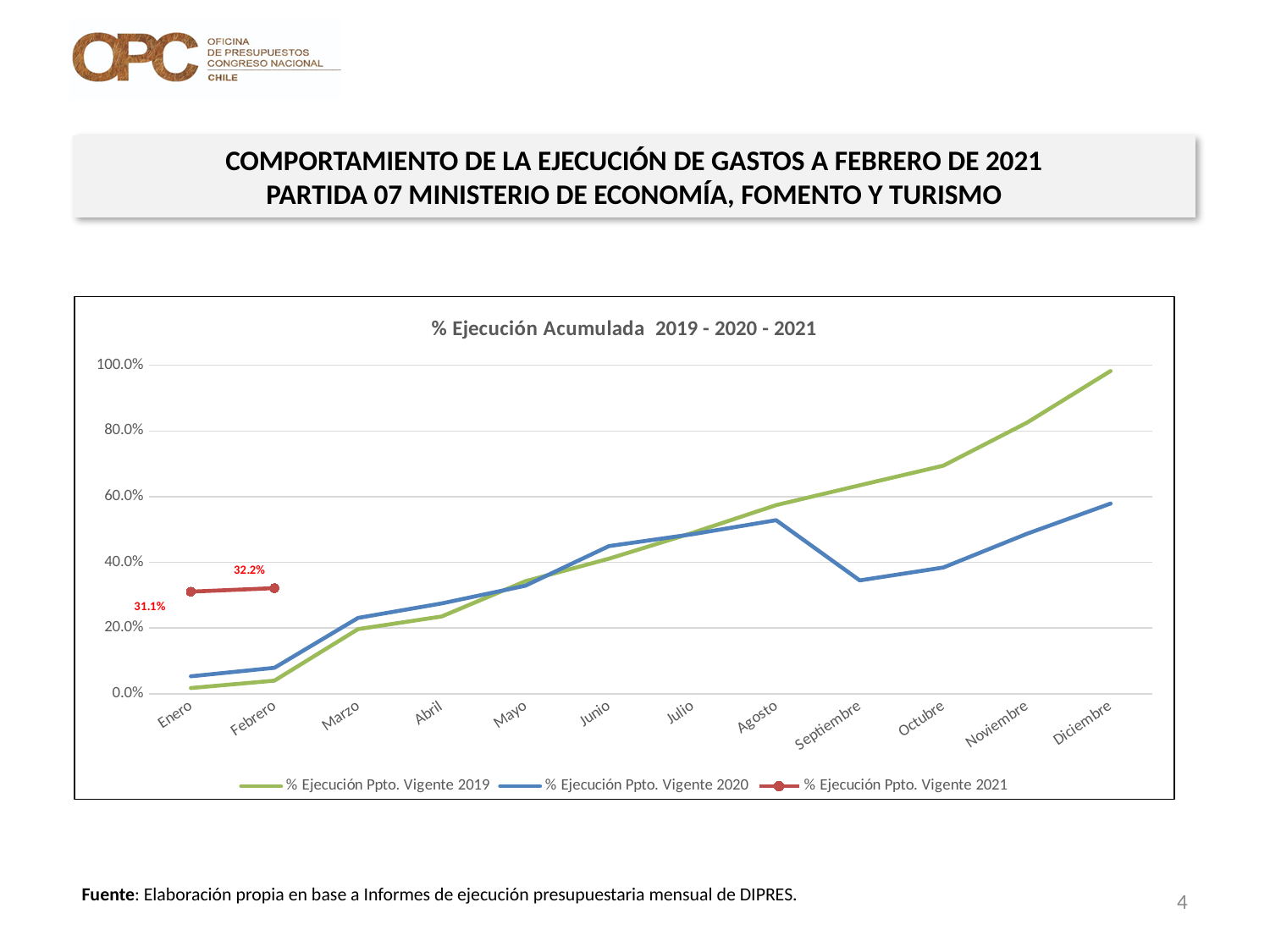
What is the title of the chart? % Ejecución Acumulada 2019 - 2020 - 2021 What is the value of % Ejecución Ppto. Vigente 2021 for Febrero? 32.2% Is the value for % Ejecución Ppto. Vigente 2020 in Septiembre greater or less than 40.0%? less In Enero, which series has the higher value: % Ejecución Ppto. Vigente 2020 or % Ejecución Ppto. Vigente 2021? % Ejecución Ppto. Vigente 2021 Is the value for % Ejecución Ppto. Vigente 2019 in Diciembre greater or less than 80.0%? greater What kind of chart is shown on the slide? Line chart Does the % Ejecución Ppto. Vigente 2019 series rise or fall from Enero to Diciembre? Rises How many series does the legend list? 3 By how much did % Ejecución Ppto. Vigente 2021 increase from Enero to Febrero? 1.1% In Diciembre, which series has the higher value: % Ejecución Ppto. Vigente 2019 or % Ejecución Ppto. Vigente 2020? % Ejecución Ppto. Vigente 2019 How many months are shown on the x axis? 12 What is the value of % Ejecución Ppto. Vigente 2021 for Enero? 31.1%